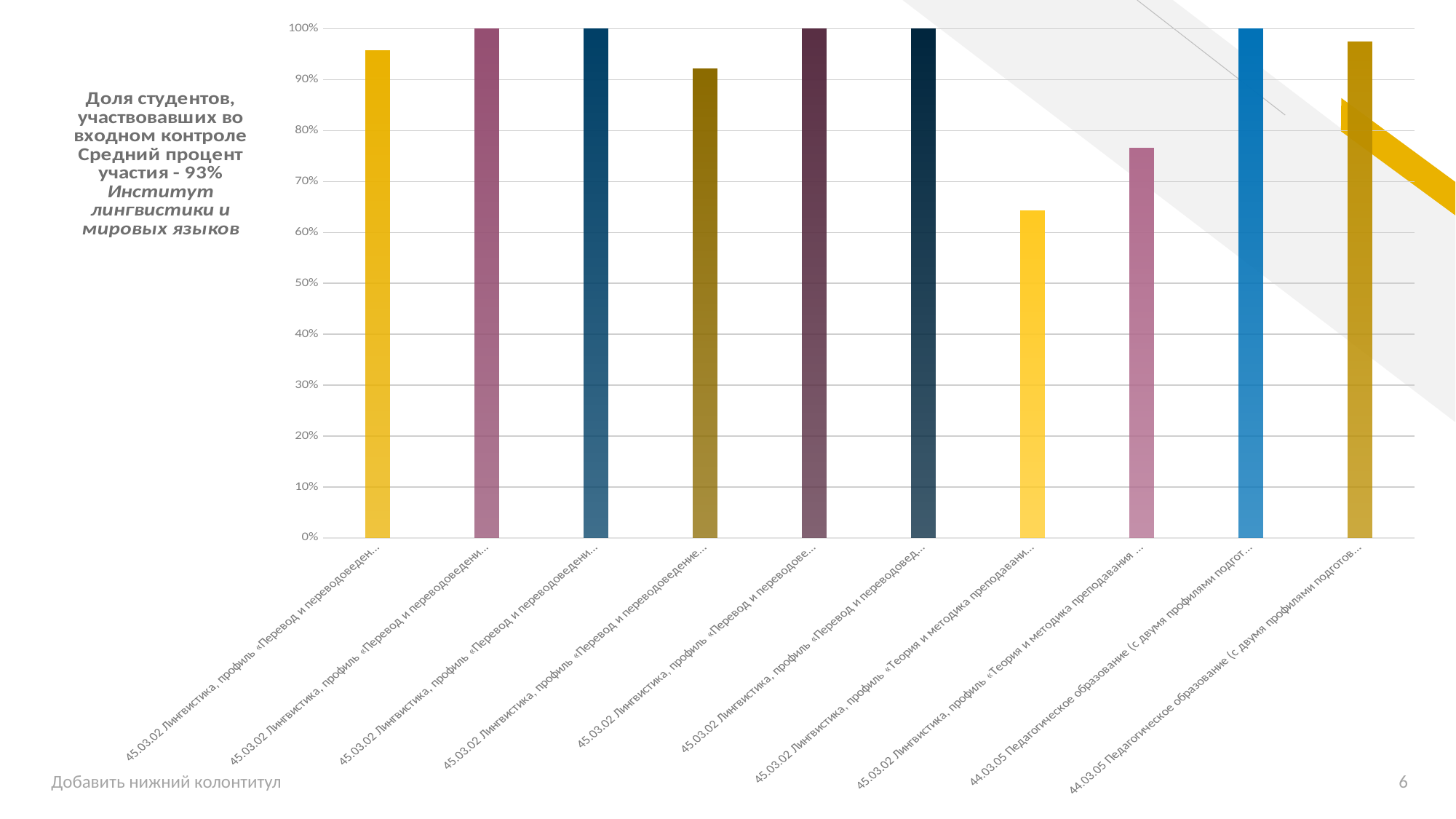
What kind of chart is shown on the slide? bar chart Which bar, counted from the left, is the lowest in the chart? the seventh bar Is the value of the fourth bar from the left greater or less than 90%? greater According to the text on the slide, what is the average participation percentage (средний процент участия)? 93% What is the value of the ninth bar from the left (the first 44.03.05 Педагогическое образование bar)? 100% How many bars (categories) are plotted in the chart? 10 How many bars reach exactly 100%? 5 Which is larger: the value of the seventh bar or the value of the eighth bar from the left? the eighth bar What is the value of the second bar from the left? 100% Is the value of the first bar from the left greater or less than 90%? greater Is the value of the seventh bar from the left greater or less than 70%? less